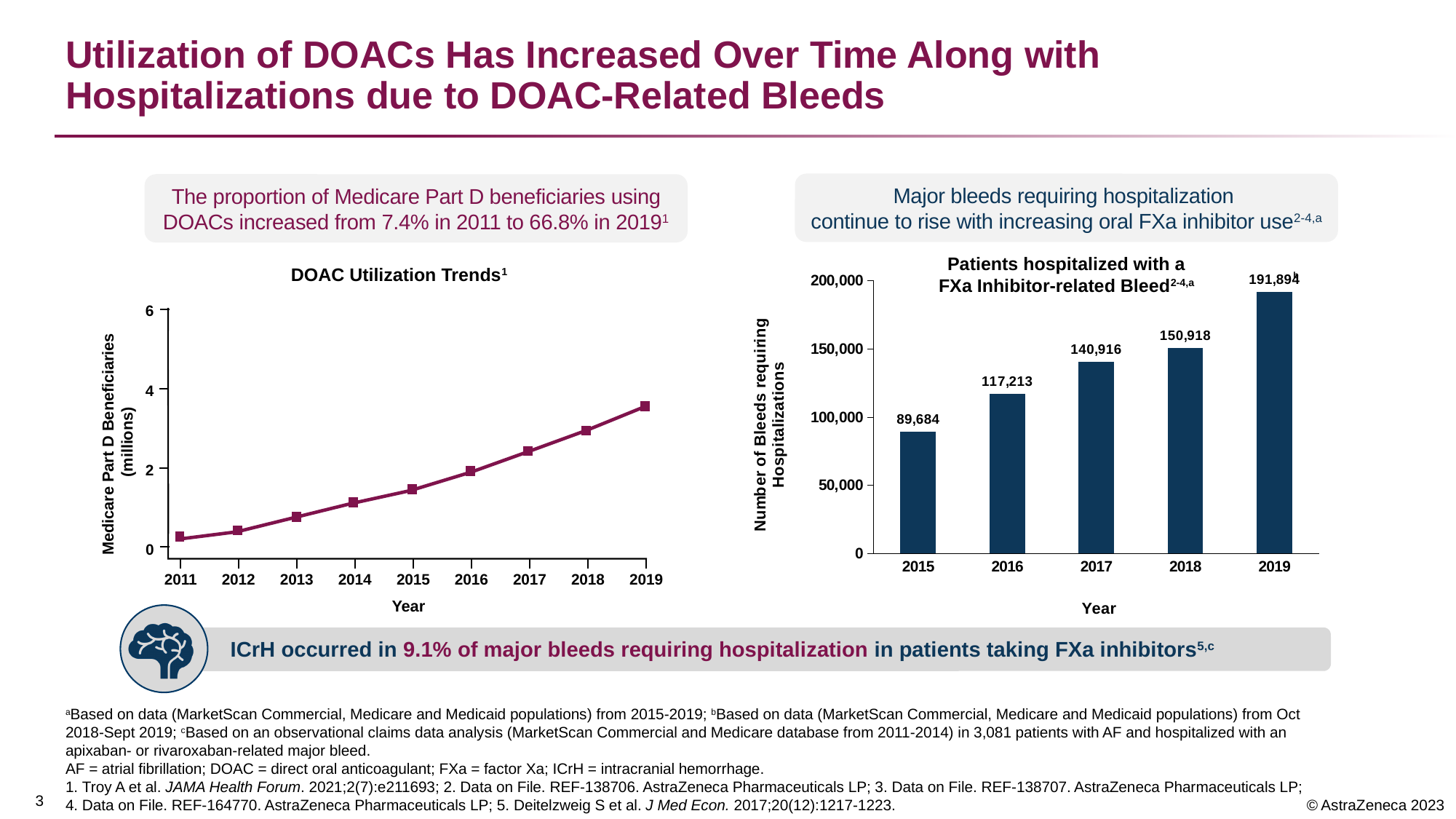
In the 'DOAC Utilization Trends' chart, is the value for 2019 greater or less than 2 million? greater In the 'Patients hospitalized with a FXa Inhibitor-related Bleed' chart, what is the value for 2015? 89,684 In the 'Patients hospitalized with a FXa Inhibitor-related Bleed' chart, what is the difference between the 2019 and 2018 values? 40,976 In the 'Patients hospitalized with a FXa Inhibitor-related Bleed' chart, what is the value for 2017? 140,916 In the 'Patients hospitalized with a FXa Inhibitor-related Bleed' chart, which year has the lowest number of bleeds requiring hospitalization? 2015 In the 'DOAC Utilization Trends' chart, how many years are plotted on the x axis? 9 What kind of chart is 'DOAC Utilization Trends'? Line chart What kind of chart is 'Patients hospitalized with a FXa Inhibitor-related Bleed'? Bar chart In the 'Patients hospitalized with a FXa Inhibitor-related Bleed' chart, how many years are shown on the x axis? 5 In the 'Patients hospitalized with a FXa Inhibitor-related Bleed' chart, what is the value for 2019? 191,894 In the 'DOAC Utilization Trends' chart, do the values rise or fall from 2011 to 2019? Rise In the 'Patients hospitalized with a FXa Inhibitor-related Bleed' chart, which year has the highest number of bleeds requiring hospitalization? 2019